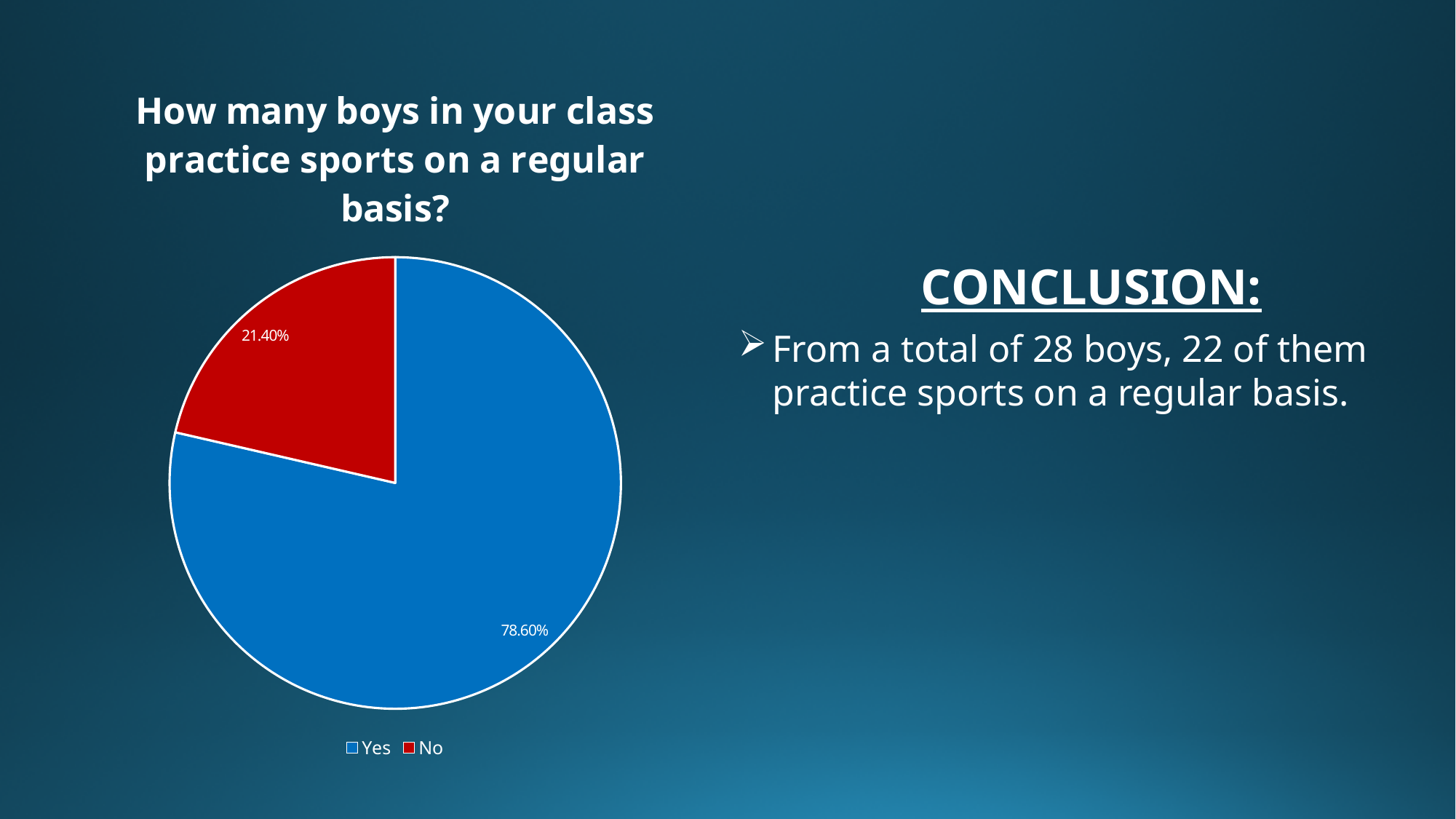
What percentage of the pie is labelled for the No slice? 21.40% How many slices does the pie chart have? 2 Which slice of the pie is the largest? Yes What colour is the Yes slice? blue What percentage of the pie is labelled for the Yes slice? 78.60% What type of chart is shown on the slide? pie chart How many entries does the legend list? 2 Which is larger, the Yes slice or the No slice? Yes Which slice of the pie is the smallest? No What share of the pie does the No slice represent? 21.40% What is the title of the chart? How many boys in your class practice sports on a regular basis? What is the difference in percentage points between the Yes slice and the No slice? 57.20%